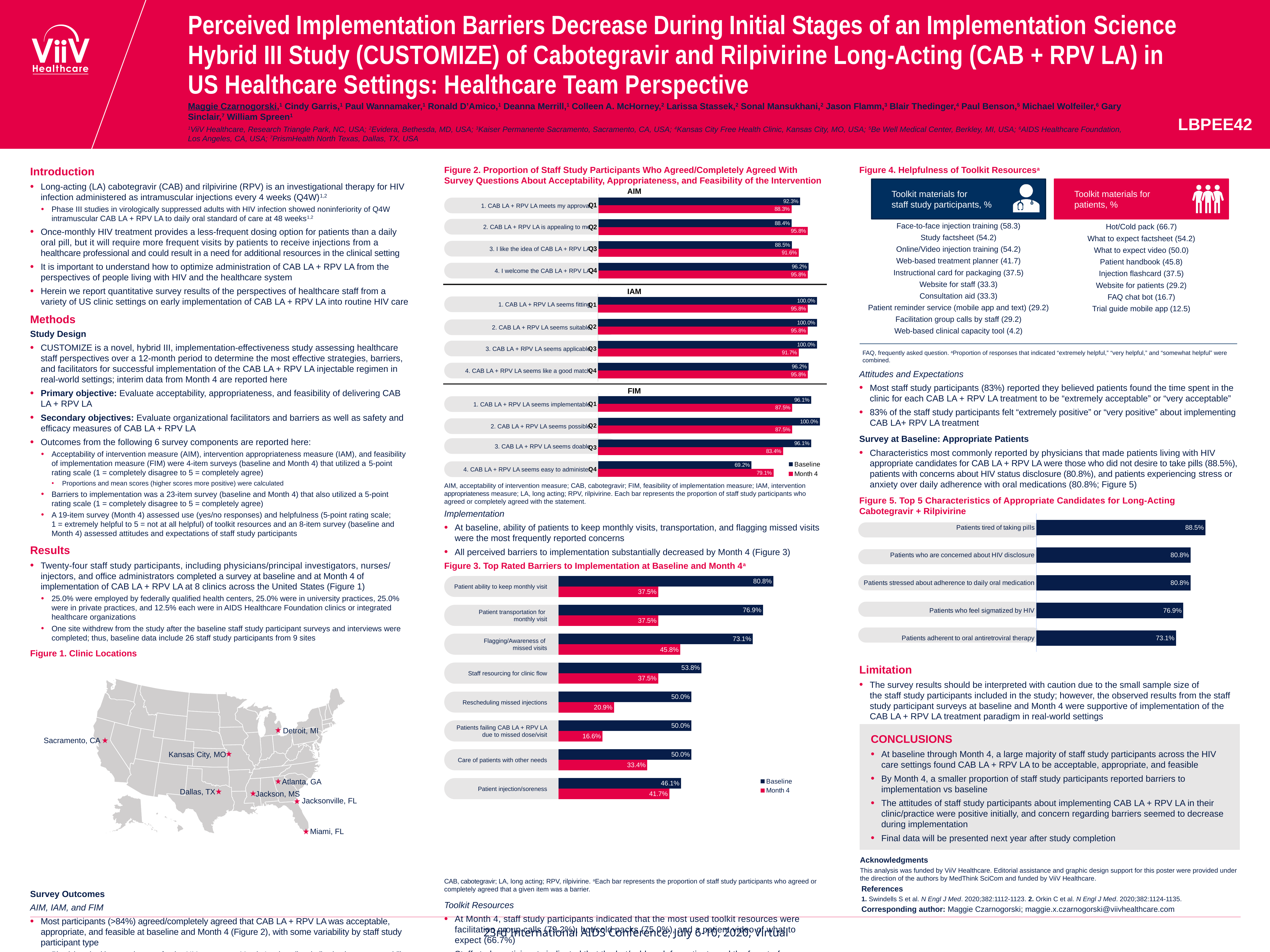
In Figure 3 (Top Rated Barriers to Implementation), how many barriers are listed? 8 In Figure 3 (Top Rated Barriers to Implementation), what is the difference between the Baseline and Month 4 values for 'Patient transportation for monthly visit'? 39.4% In Figure 3 (Top Rated Barriers to Implementation), what is the Month 4 value for 'Patients failing CAB LA + RPV LA due to missed dose/visit'? 16.6% In Figure 3 (Top Rated Barriers to Implementation), which barrier has the highest Baseline value? Patient ability to keep monthly visit In Figure 3 (Top Rated Barriers to Implementation), how many series does the legend list? 2 In Figure 5 (Top 5 Characteristics of Appropriate Candidates), what is the value for 'Patients who feel sigmatized by HIV'? 76.9% In Figure 3 (Top Rated Barriers to Implementation), what is the Baseline value for 'Patient ability to keep monthly visit'? 80.8% In Figure 5 (Top 5 Characteristics of Appropriate Candidates), which characteristic has the highest value? Patients tired of taking pills In Figure 3 (Top Rated Barriers to Implementation), which barrier has the lowest Month 4 value? Patients failing CAB LA + RPV LA due to missed dose/visit In Figure 2, IAM section, is the Baseline value for Q1 'CAB LA + RPV LA seems fitting' larger or smaller than the Month 4 value? Larger In Figure 2, FIM section, what is the Baseline value for Q4 'CAB LA + RPV LA seems easy to administer'? 69.2% What kind of chart is Figure 5 (Top 5 Characteristics of Appropriate Candidates)? Bar chart